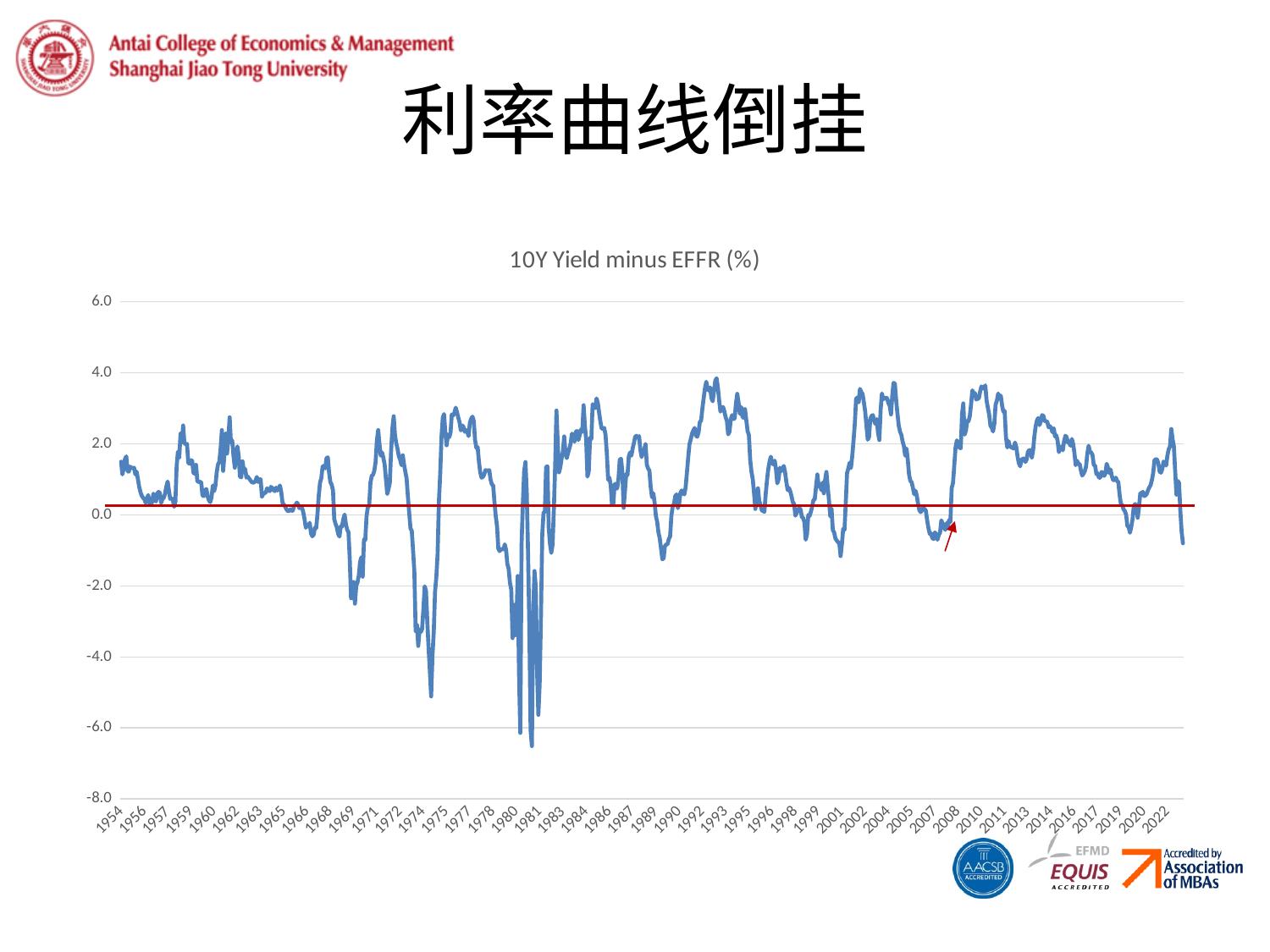
Which is larger, the value of the line around 1969 or around 1974? 1969 What is the first year shown on the x axis of the chart? 1954 What is the last year shown on the x axis of the chart? 2022 Is the lowest point of the line around 1980 greater or less than -6.0? less What is the title of the chart? 10Y Yield minus EFFR (%) Is the value of the line around 1974 greater or less than -4.0? less What is the lowest value shown on the y axis of the chart? -8.0 Is the value of the line around 1993 greater or less than 2.0? greater What is the highest value shown on the y axis of the chart? 6.0 What colour is the horizontal reference line drawn near 0.0 on the chart? red Around which year does the line reach its lowest point? 1981 What kind of chart is shown on the slide? line chart